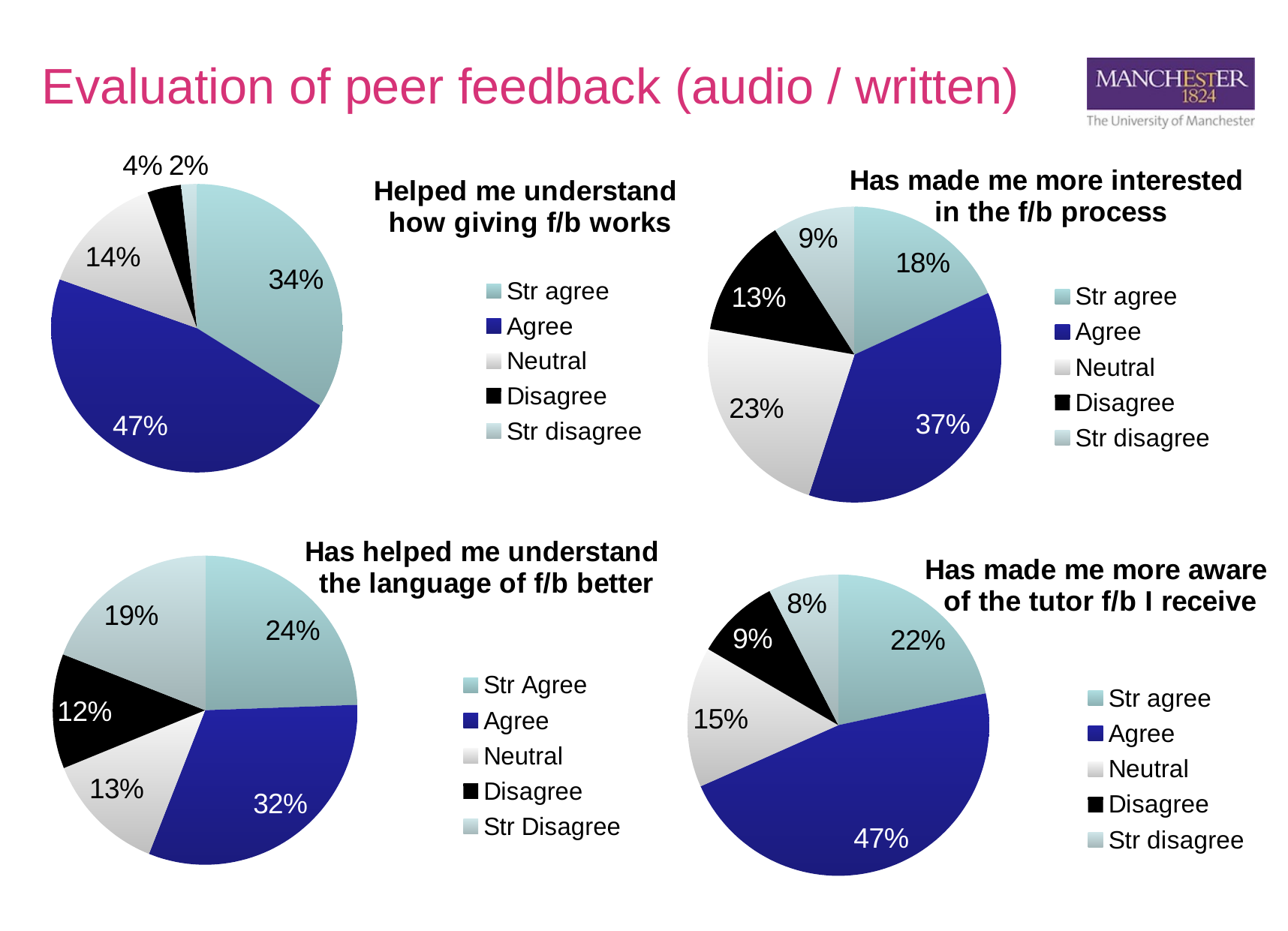
In the chart titled 'Has helped me understand the language of f/b better', which is larger, Str Agree or Str Disagree? Str Agree What type of chart is used for 'Has helped me understand the language of f/b better'? Pie chart In the chart titled 'Has made me more aware of the tutor f/b I receive', what percentage is shown for Disagree? 9% In the chart titled 'Has helped me understand the language of f/b better', what percentage is shown for Str Disagree? 19% In the chart titled 'Helped me understand how giving f/b works', which category has the smallest slice? Str disagree How many categories does the legend list in the chart titled 'Has made me more aware of the tutor f/b I receive'? 5 In the chart titled 'Has made me more interested in the f/b process', which category has the largest slice? Agree In the chart titled 'Has made me more aware of the tutor f/b I receive', what is the combined share of Str agree and Agree? 69% How many pie charts are shown on the slide? 4 In the chart titled 'Has made me more interested in the f/b process', what is the difference between the Agree and Str agree percentages? 19% In the chart titled 'Helped me understand how giving f/b works', what percentage is shown for Agree? 47% In the chart titled 'Has made me more interested in the f/b process', what percentage is shown for Neutral? 23%